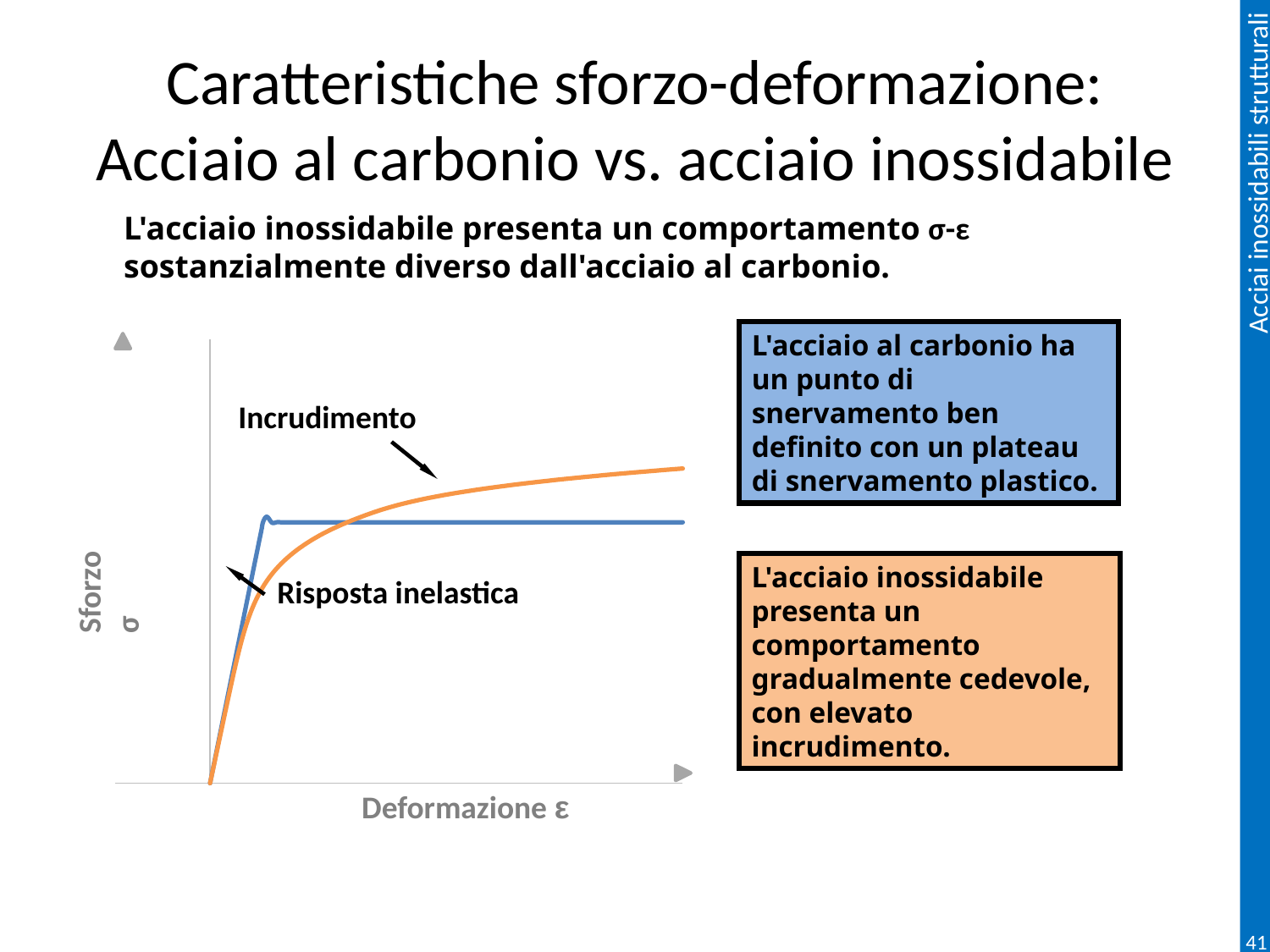
Does the orange curve rise or fall as deformation increases along the x axis? Rise How many curves are plotted on the chart? 2 After its initial rise, does the blue curve keep rising or stay flat as deformation increases? Stay flat Which curve does the annotation 'Incrudimento' point to, the blue one or the orange one? Orange What is the label of the vertical axis of the chart? Sforzo σ What is the label of the horizontal axis of the chart? Deformazione ε What kind of chart is shown on the slide? Line chart At the right end of the chart, which curve shows the higher stress, the blue one or the orange one? Orange